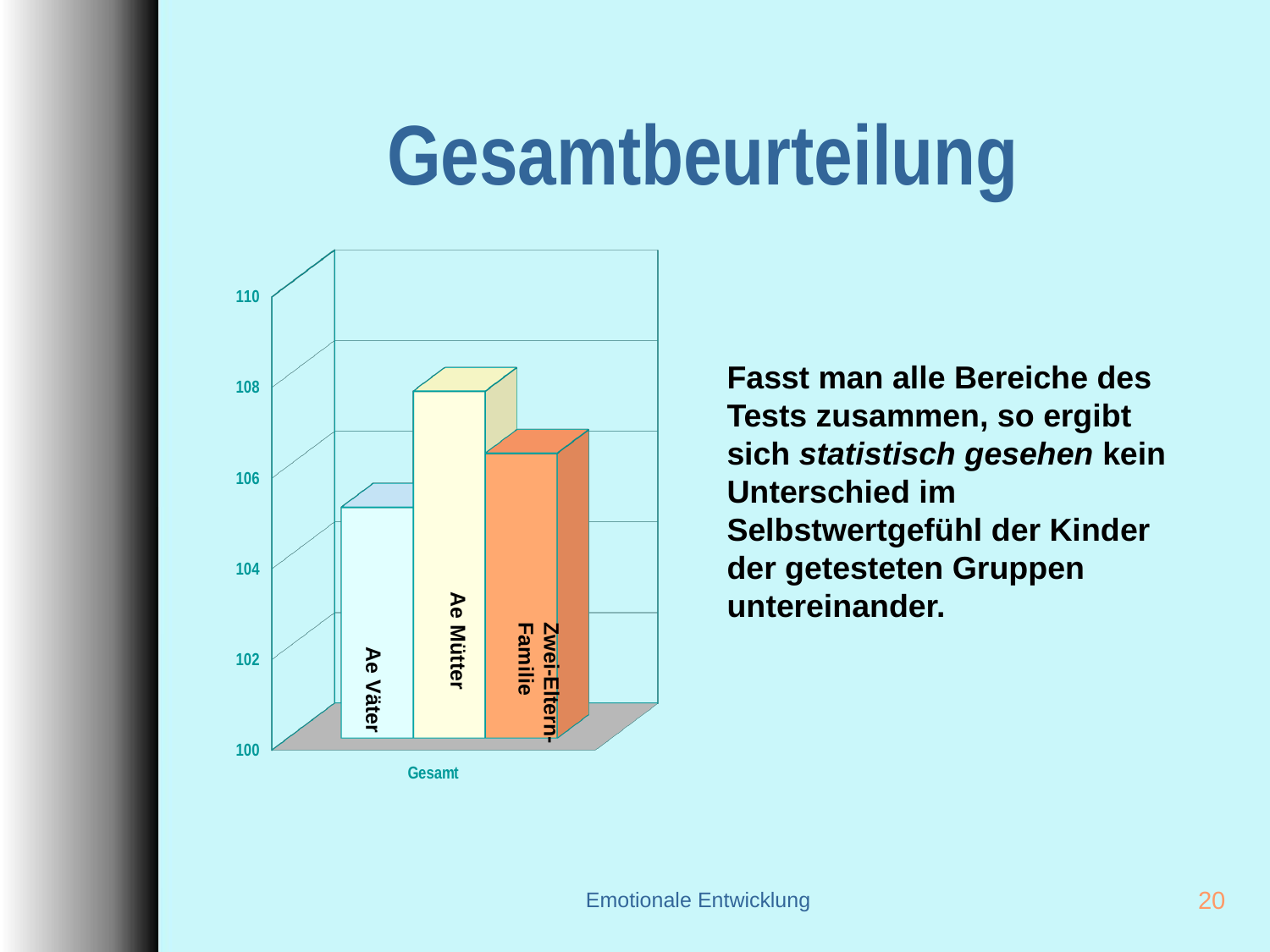
Which bar is taller, Ae Väter or Zwei-Eltern-Familie? Zwei-Eltern-Familie Is the value for Ae Väter greater or less than 104? greater What label is shown on the category axis below the bars? Gesamt Is the value for Ae Mütter greater or less than 106? greater Which group has the highest bar in the chart? Ae Mütter Which bar is taller, Ae Mütter or Zwei-Eltern-Familie? Ae Mütter Is the value for Zwei-Eltern-Familie greater or less than 108? less What kind of chart is shown on the slide? bar chart How many bars are plotted in the chart? 3 What is the title of the slide containing the chart? Gesamtbeurteilung Which group has the lowest bar in the chart? Ae Väter